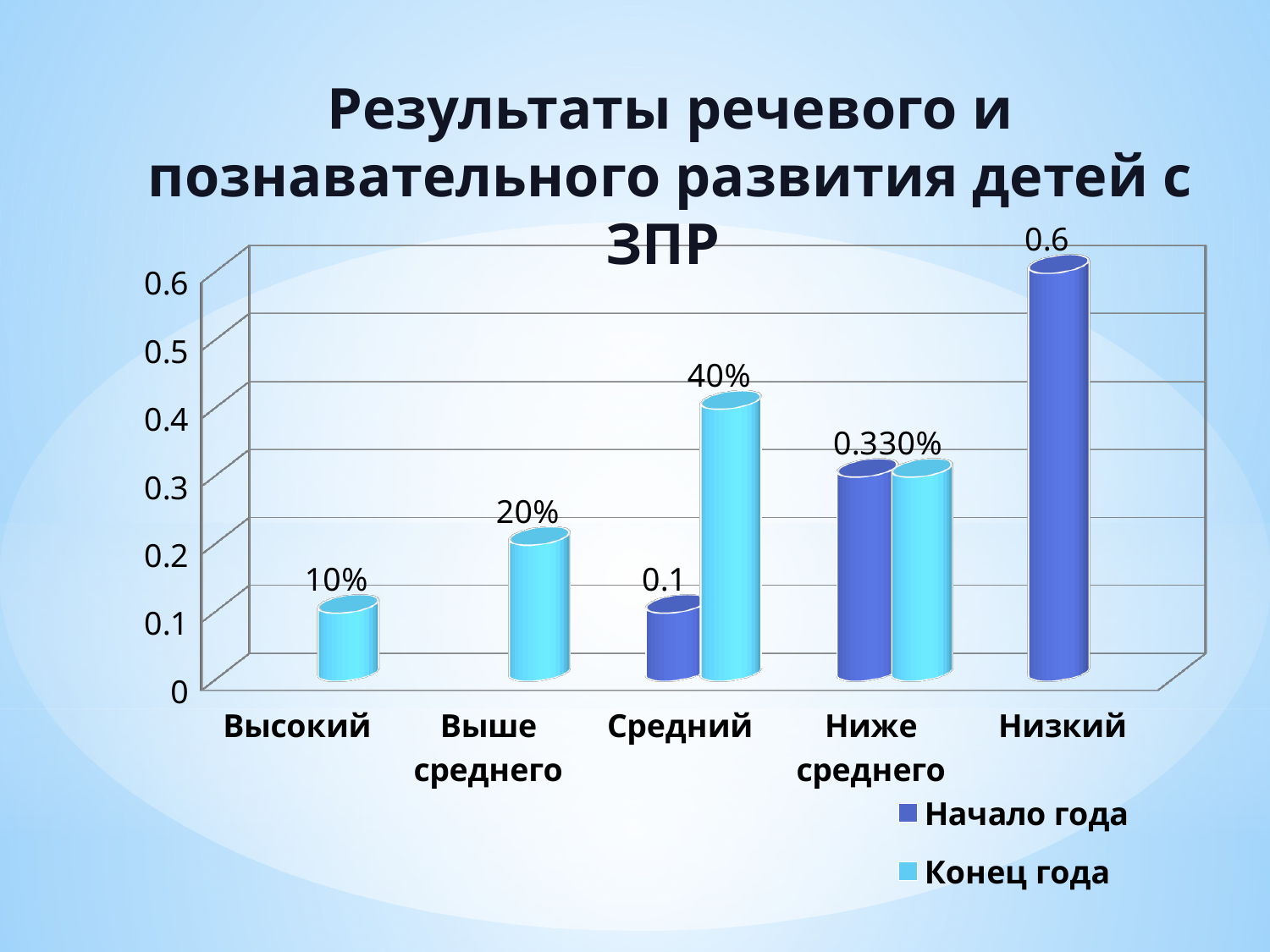
For the Средний category, which series has the larger value, Начало года or Конец года? Конец года What is the value for Низкий in the Начало года series? 0.6 How many categories are shown on the x axis? 5 Which category has the highest value in the Начало года series? Низкий What kind of chart is shown on the slide? bar chart What is the value for Выше среднего in the Конец года series? 20% What is the value for Высокий in the Конец года series? 10% What is the value for Средний in the Начало года series? 0.1 Which category has the highest value in the Конец года series? Средний What is the value for Средний in the Конец года series? 40% Is the Начало года value for Ниже среднего greater or less than 0.2? greater How many series does the legend list? 2